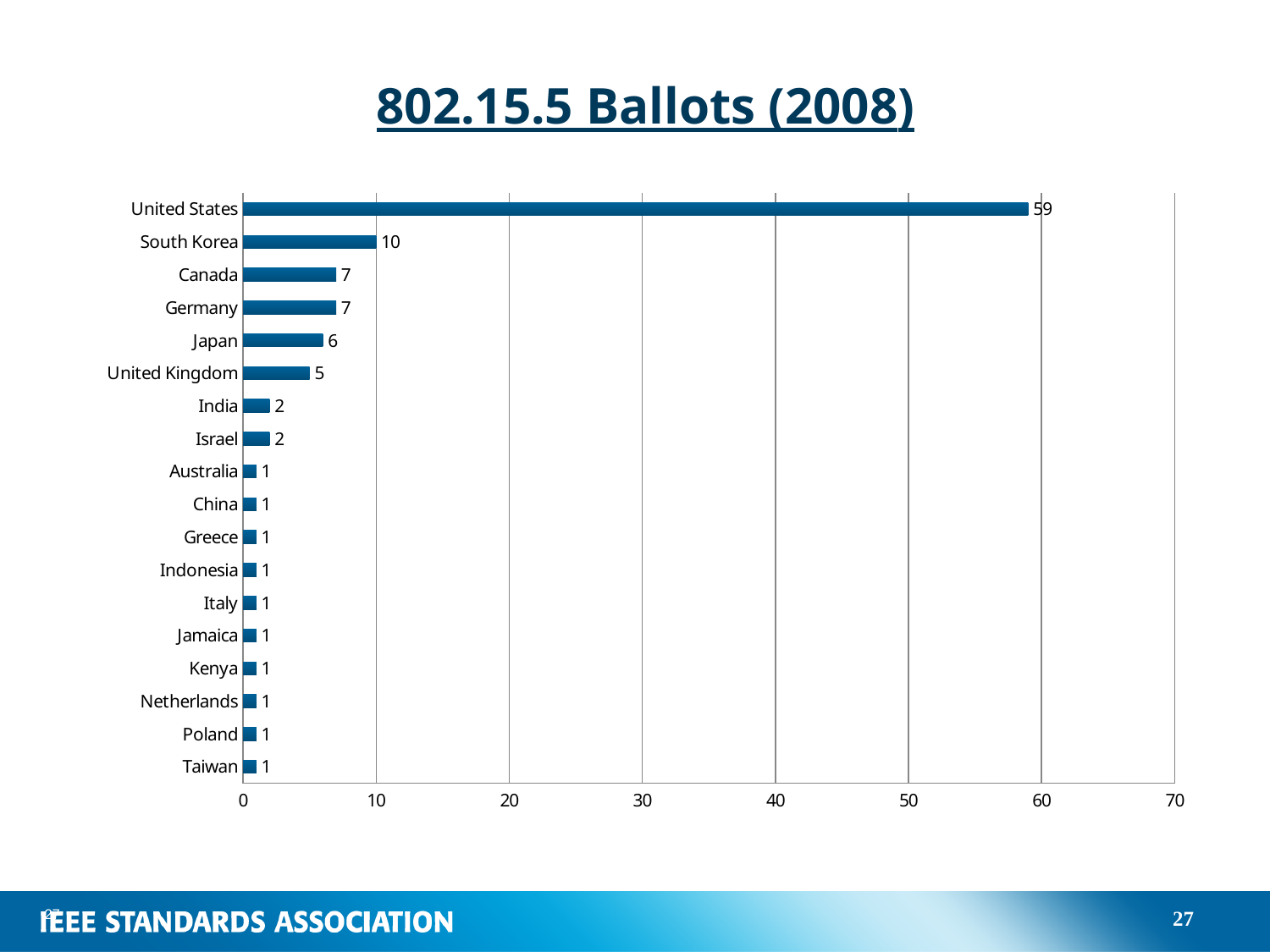
Is the value for United States greater or less than 50? greater What is the value for United States? 59 What kind of chart is shown on the slide? Bar chart What is the value for Japan? 6 What is the value for United Kingdom? 5 What is the value for South Korea? 10 What is the difference between the values for Canada and India? 5 How many countries are shown in the chart? 18 Which is larger, the value for Japan or the value for United Kingdom? Japan What is the title of the chart? 802.15.5 Ballots (2008) What is the difference between the values for United States and South Korea? 49 Which country has the highest value? United States